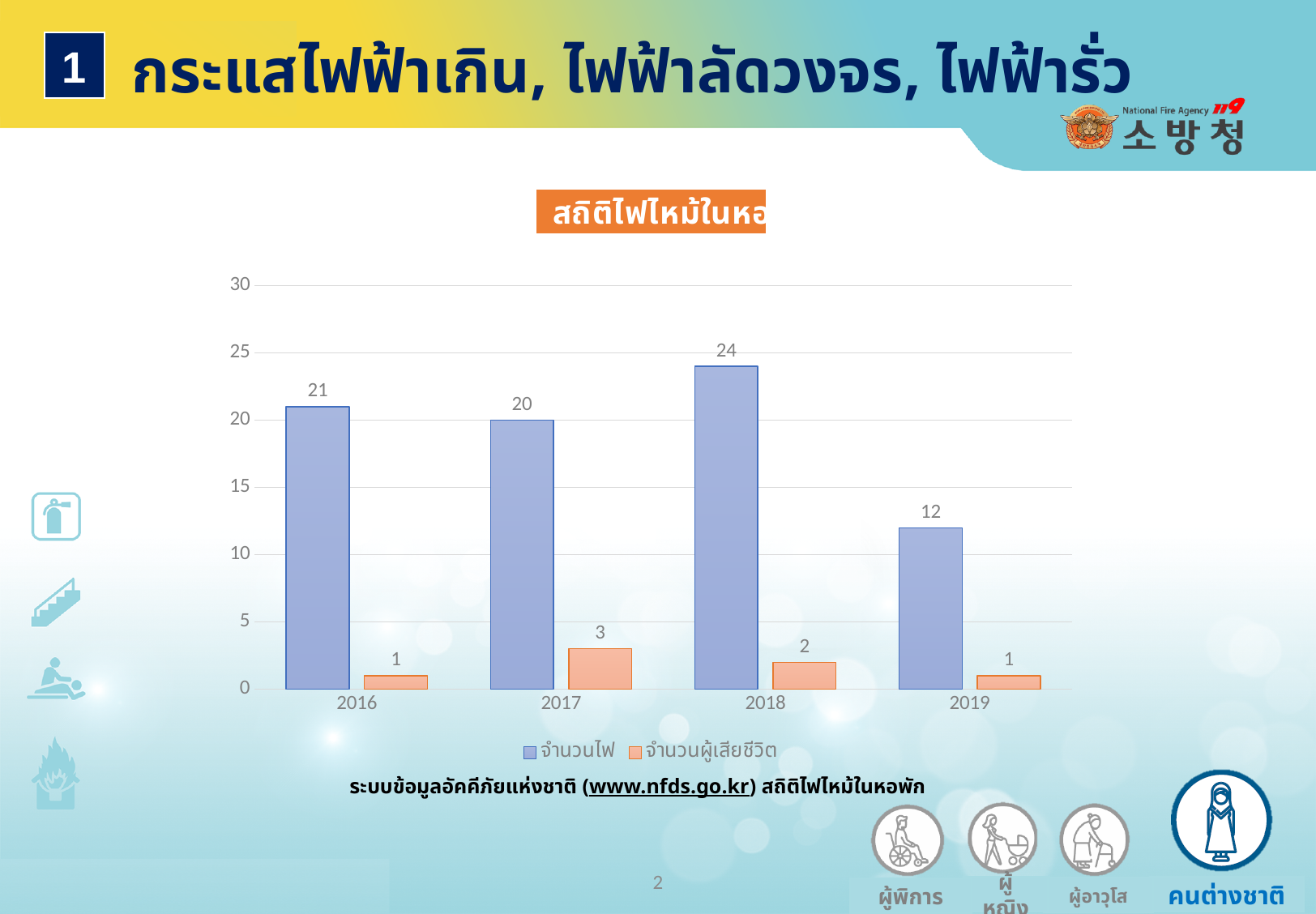
Which year has the lowest value for จำนวนไฟ? 2019 What is the difference between จำนวนไฟ in 2018 and 2019? 12 Which colour represents จำนวนผู้เสียชีวิต in the legend? orange Which year has the highest value for จำนวนผู้เสียชีวิต? 2017 How many years are shown on the x axis? 4 What is the value of จำนวนไฟ for 2019? 12 How many series does the legend list? 2 Which year has the highest value for จำนวนไฟ? 2018 Which is larger, จำนวนไฟ in 2016 or in 2017? 2016 What is the value of จำนวนผู้เสียชีวิต for 2017? 3 What type of chart is shown on the slide? bar chart What is the value of จำนวนไฟ for 2018? 24